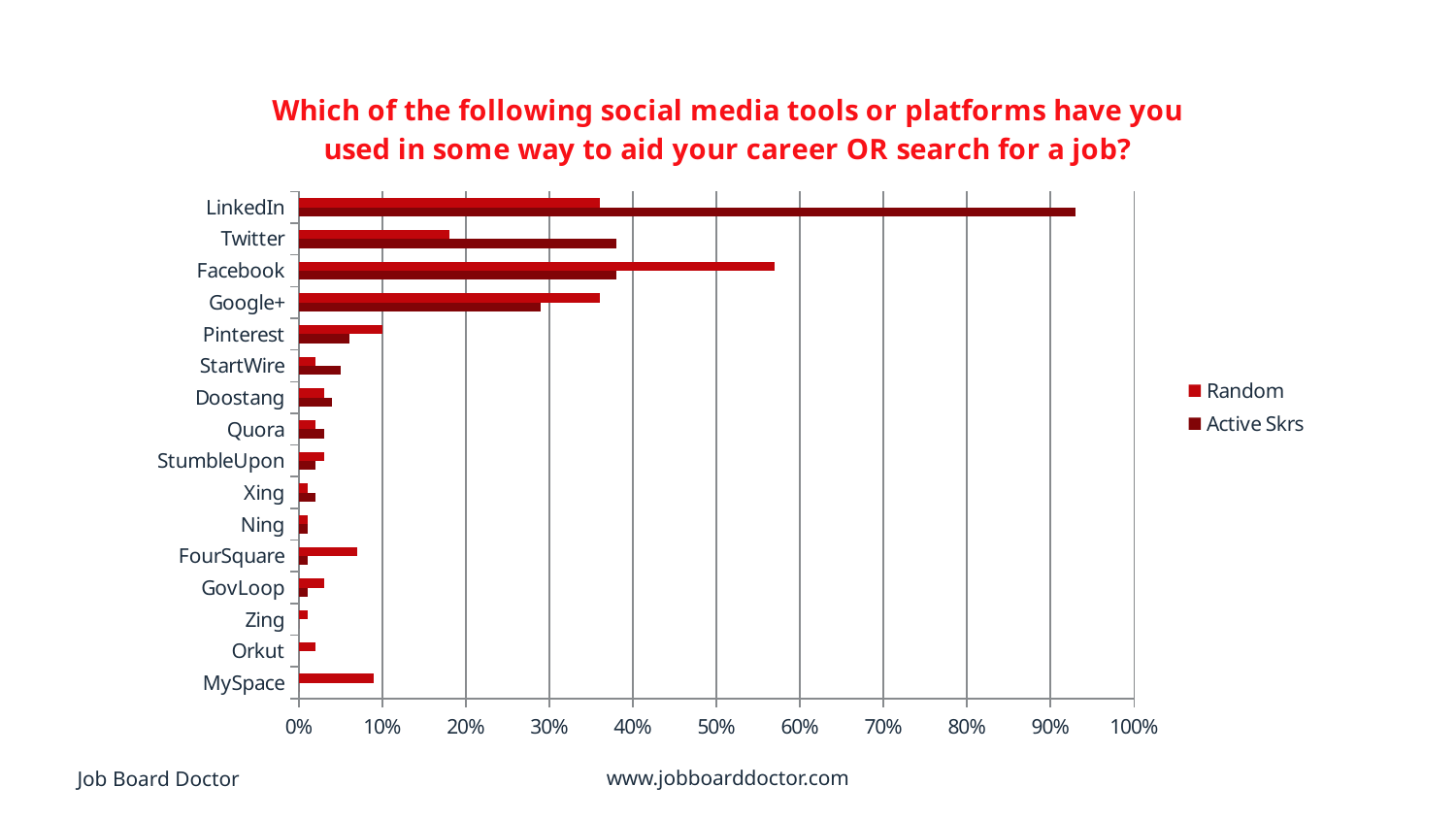
What are the two series named in the legend? Random and Active Skrs Is the Random value for Facebook greater or less than 50%? greater Which is larger for the Active Skrs series: LinkedIn or Facebook? LinkedIn Which is larger for the Random series: Facebook or Twitter? Facebook What kind of chart is shown on the slide? bar chart Which platform has the highest value for the Random series? Facebook Is the Random value for Twitter greater or less than 20%? less How many social media platforms are listed on the chart? 16 Is the Active Skrs value for LinkedIn greater or less than 90%? greater Which platform has the highest value for the Active Skrs series? LinkedIn How many series does the legend list? 2